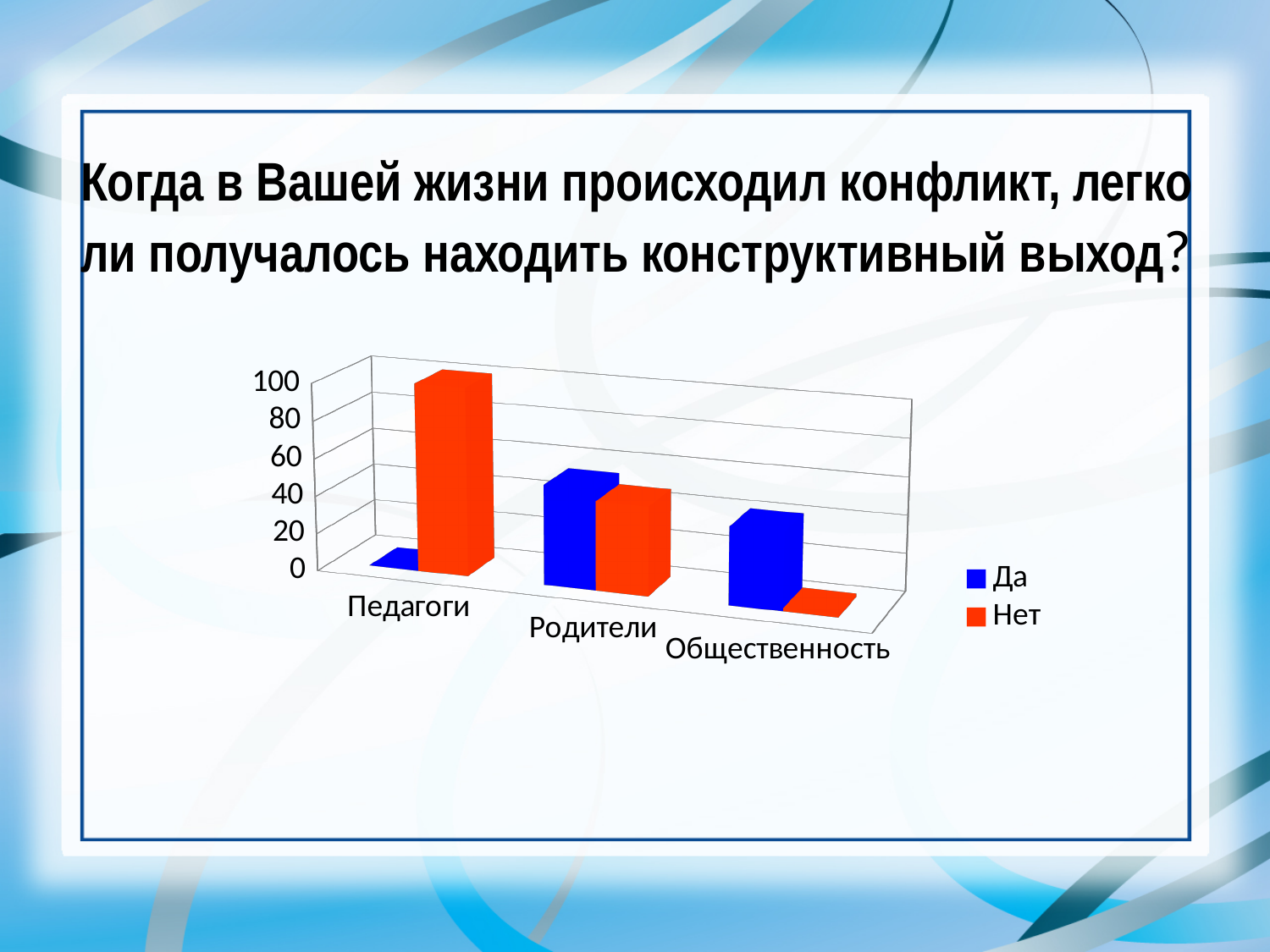
How many series does the chart legend list? 2 Which category has the lowest value for the series "Нет"? Общественность For the category Общественность, which series has the larger value, "Да" or "Нет"? Да Which category has the highest value for the series "Нет"? Педагоги What kind of chart is shown on the slide? bar chart Which category has the lowest value for the series "Да"? Педагоги How many categories are shown on the x axis of the chart? 3 Which category has the highest value for the series "Да"? Родители Is the value for "Да" in the category Педагоги greater or less than 20? less Is the value for "Нет" in the category Общественность greater or less than 20? less Which colour represents the series "Нет" in the chart? red Is the value for "Нет" in the category Педагоги greater or less than 80? greater